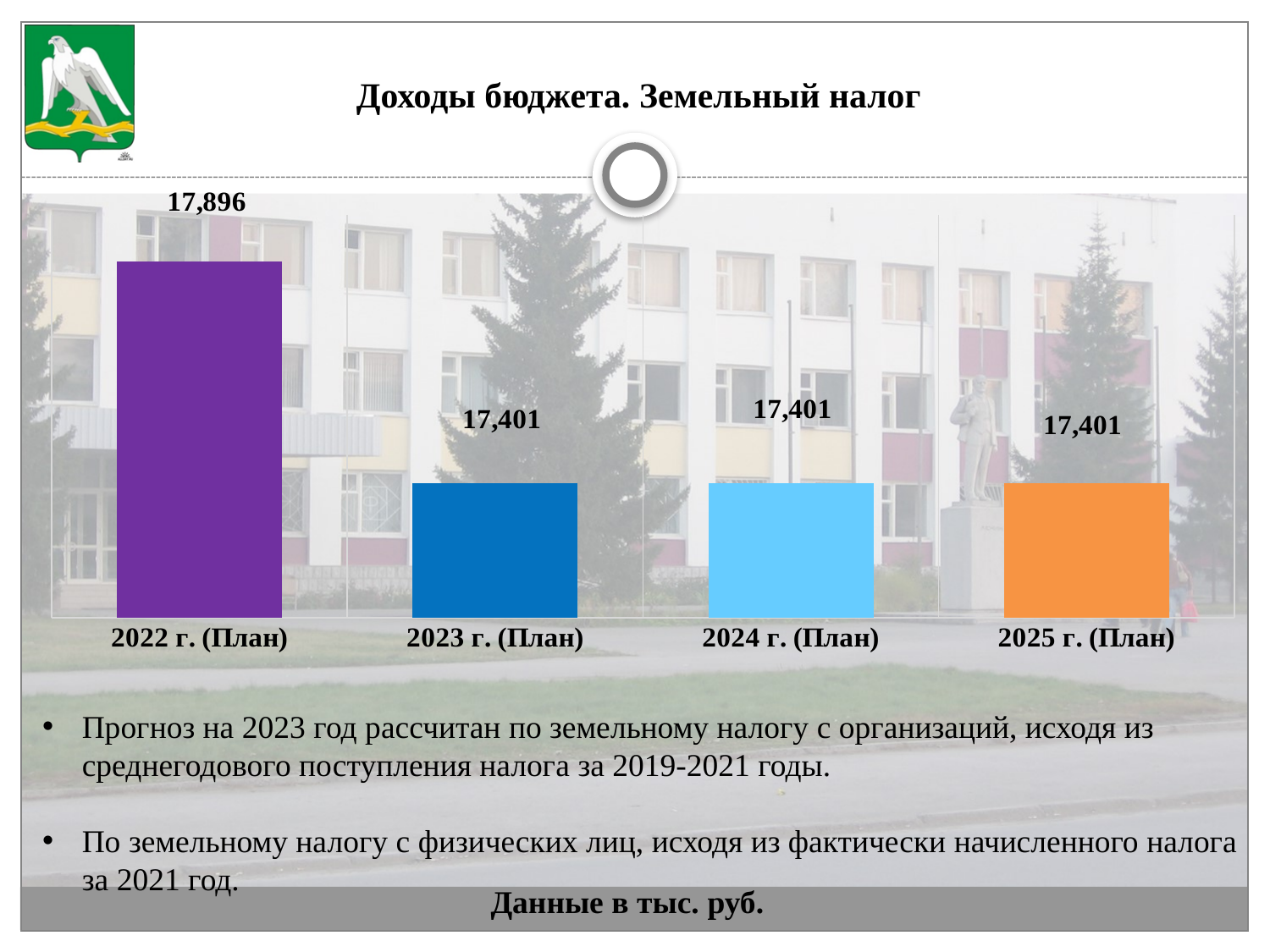
Which category has the highest value? 2022 г. (План) What is the title of the chart? Доходы бюджета. Земельный налог What kind of chart is shown on the slide? Bar chart What is the difference between the values for 2022 г. (План) and 2023 г. (План)? 495 How many categories are shown in the chart? 4 Which is larger, the value for 2022 г. (План) or the value for 2024 г. (План)? 2022 г. (План) What is the value for 2023 г. (План)? 17,401 Are the values for 2023 г. (План) and 2024 г. (План) the same? Yes Does the value rise or fall from 2022 г. (План) to 2023 г. (План)? Fall In what units are the chart's values given? тыс. руб. What is the value for 2022 г. (План)? 17,896 What is the value for 2025 г. (План)? 17,401